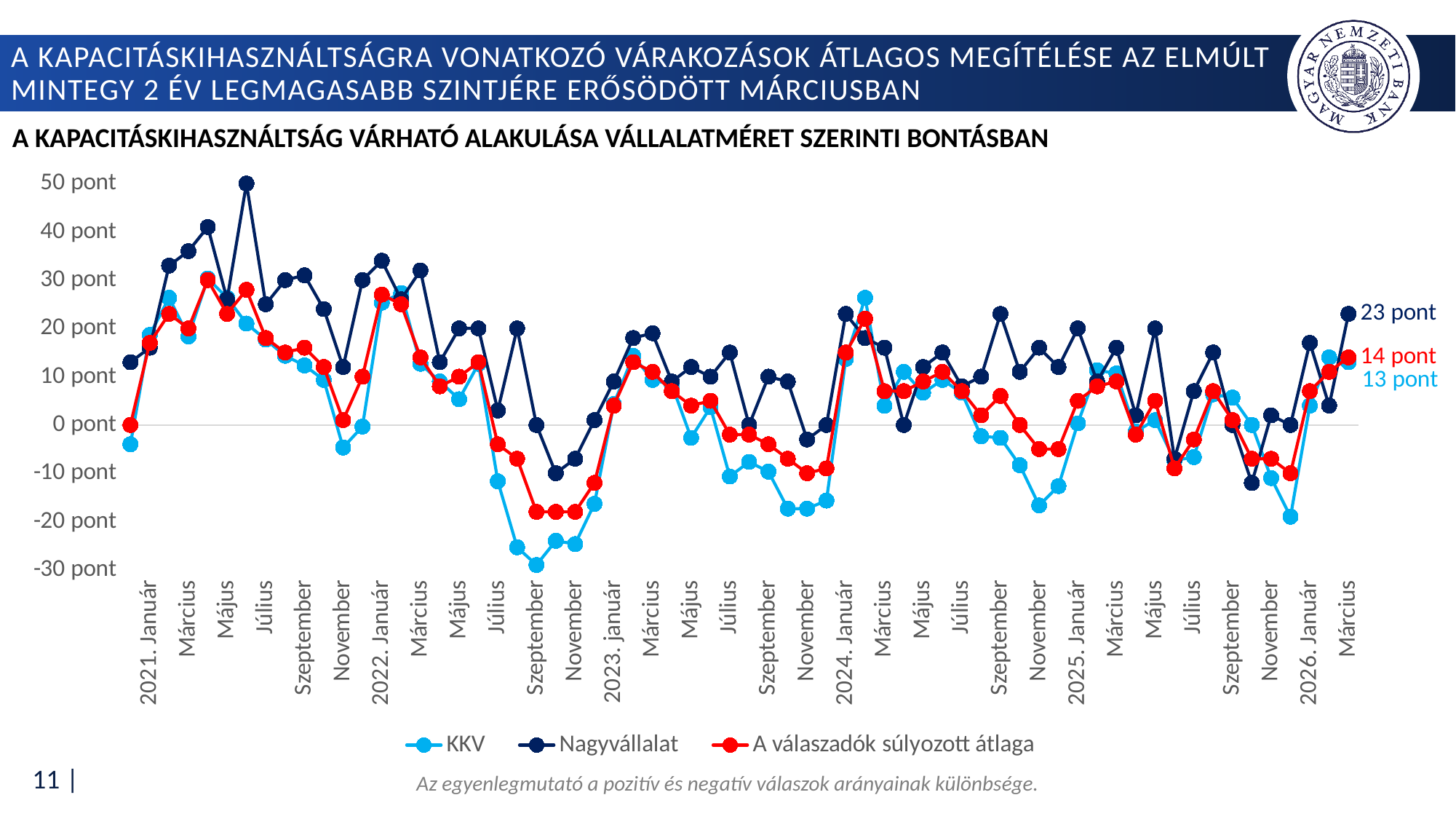
What is the value for KKV at the last point (2026 Március)? 13 pont Is the Nagyvállalat value in 2021 Május greater or less than 40 pont? less At the last point (2026 Március), which is larger: the Nagyvállalat value or the KKV value? Nagyvállalat What kind of chart is shown on the slide? Line chart What is the value for A válaszadók súlyozott átlaga at the last point (2026 Március)? 14 pont What is the value for Nagyvállalat at the last point (2026 Március)? 23 pont What is the difference between the Nagyvállalat and KKV values at the last point (2026 Március)? 10 pont Which series has the lowest value at the last point (2026 Március)? KKV Which series reaches the highest value anywhere on the chart? Nagyvállalat How many series does the legend list? 3 Is the KKV value in 2022 Szeptember greater or less than -20 pont? less Does the KKV series rise or fall from 2022 Május to 2022 Szeptember? Fall